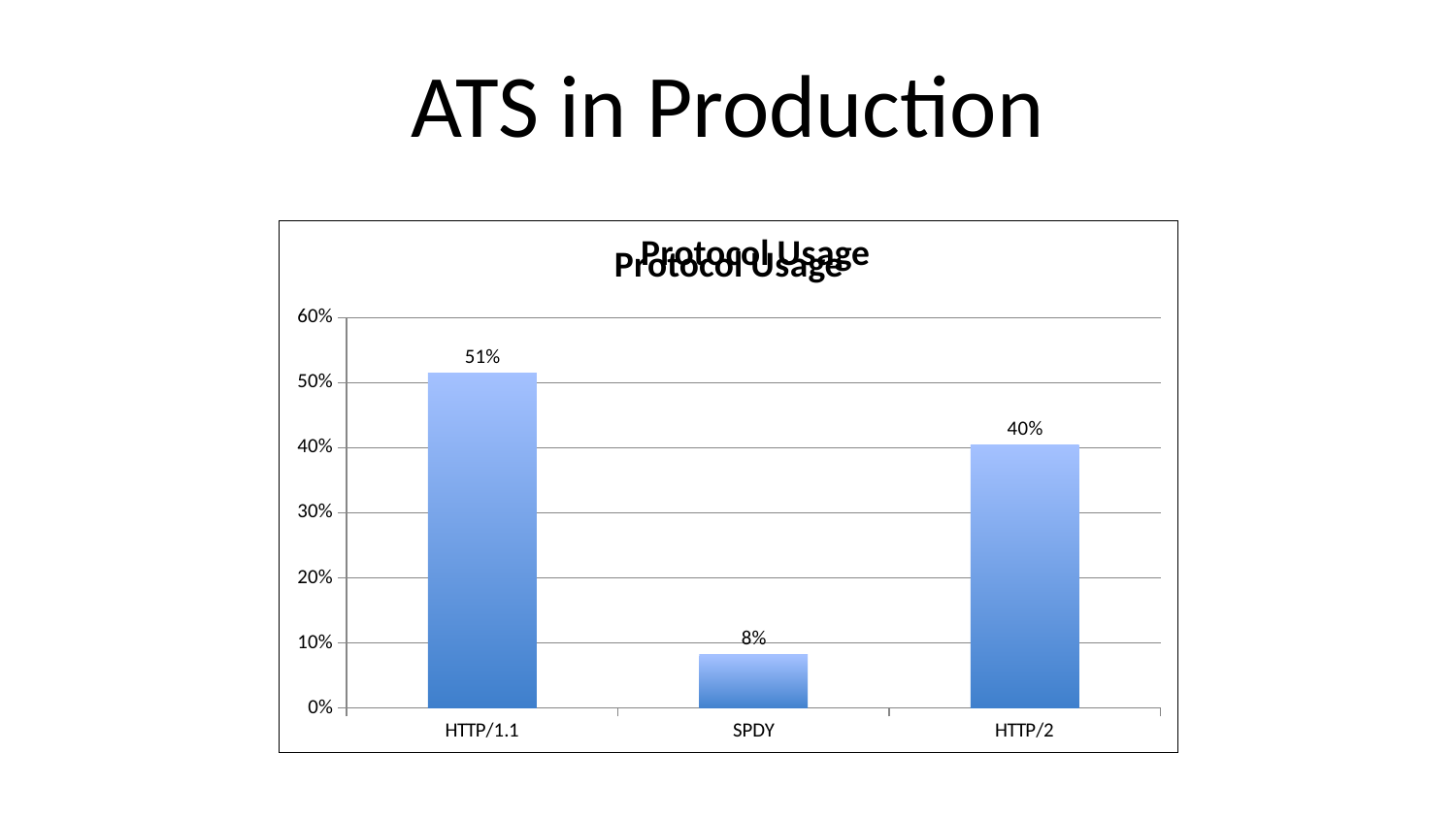
Is the value for HTTP/1.1 greater or less than 50%? greater Which is larger, the value for SPDY or the value for HTTP/2? HTTP/2 What is the value for SPDY? 8% What is the value for HTTP/2? 40% What is the difference between the values for HTTP/2 and SPDY? 32% What is the difference between the values for HTTP/1.1 and HTTP/2? 11% Which protocol has the highest usage? HTTP/1.1 Which protocol has the lowest usage? SPDY What kind of chart is shown on the slide? bar chart What is the title of the chart? Protocol Usage How many protocols are shown on the chart? 3 What is the value for HTTP/1.1? 51%